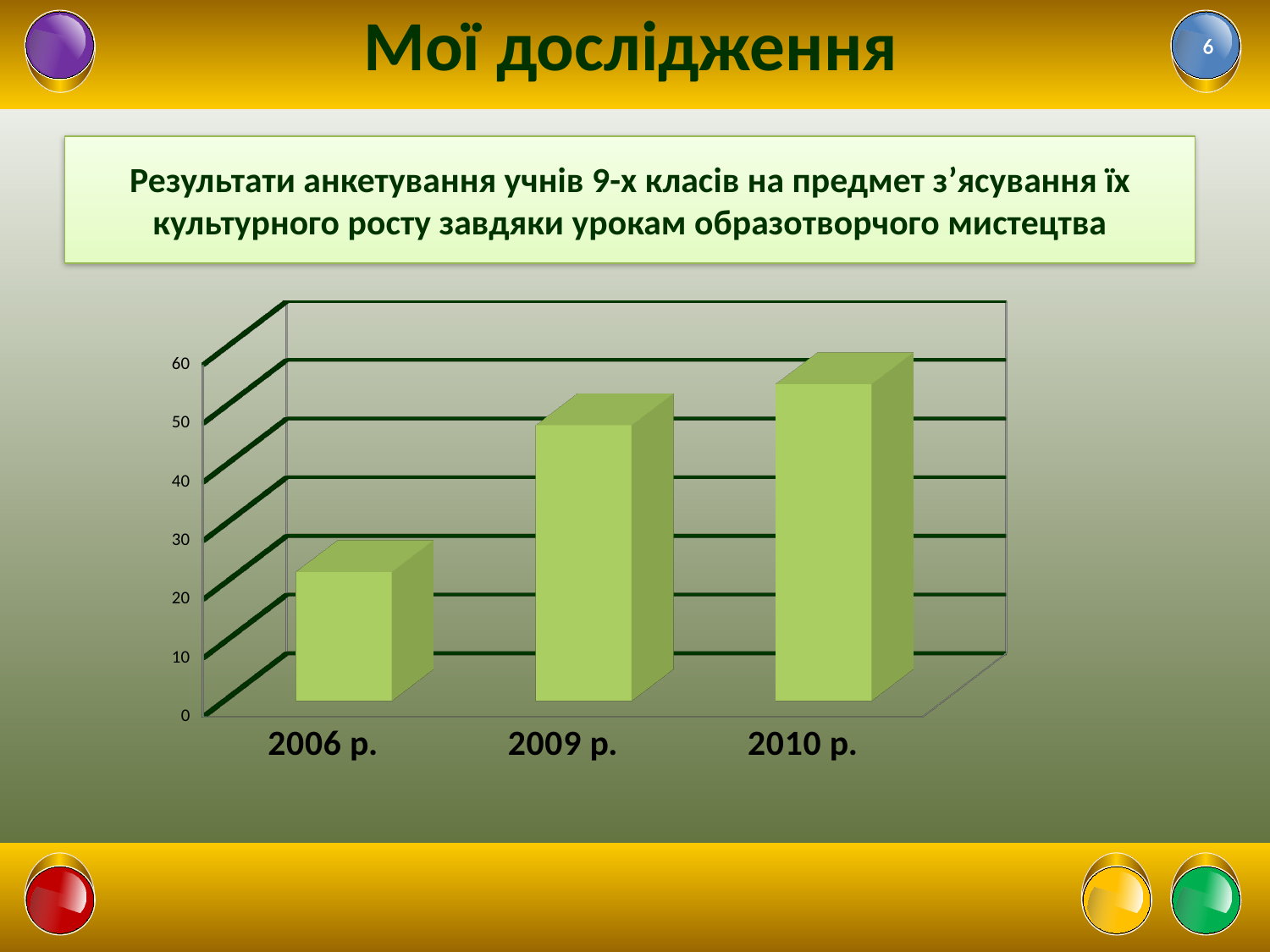
Which bar is taller, 2009 р. or 2010 р.? 2010 р. Is the value for 2006 р. greater or less than 30? less Is the value for 2009 р. greater or less than 40? greater Which bar is taller, 2006 р. or 2009 р.? 2009 р. Is the value for 2006 р. greater or less than 10? greater How many categories (years) are shown on the x axis of the chart? 3 What kind of chart is shown on the slide? bar chart Which year has the lowest bar in the chart? 2006 р. Do the bar values rise or fall from 2006 р. to 2010 р.? rise Which year has the highest bar in the chart? 2010 р. What is the highest value shown on the vertical axis of the chart? 60